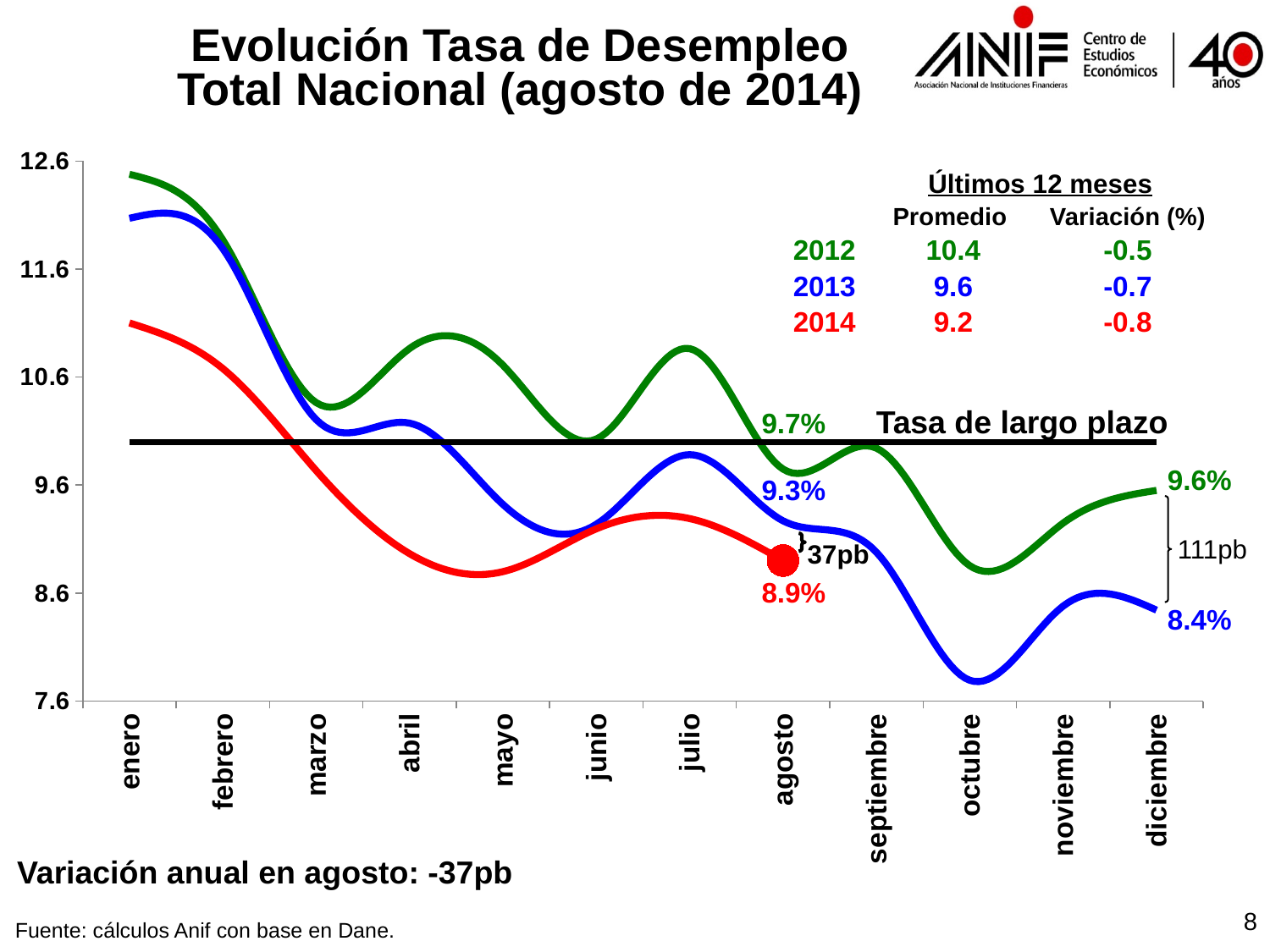
What is the labelled value of the 2013 line in agosto? 9.3% Is the value of the 2013 line in octubre greater or less than 8.6? less What is the label on the horizontal black line in the chart? Tasa de largo plazo Which series has the lowest value in agosto? 2014 What is the labelled gap between the 2012 and 2013 lines in diciembre? 111pb What is the labelled value of the 2012 line in agosto? 9.7% What is the labelled value of the 2014 line in agosto? 8.9% Which is higher in enero, the 2012 line or the 2013 line? 2012 What kind of chart is shown on the slide? line chart What is the labelled value of the 2013 line in diciembre? 8.4% How many months are shown on the x axis? 12 How many series (years) are plotted on the chart? 3